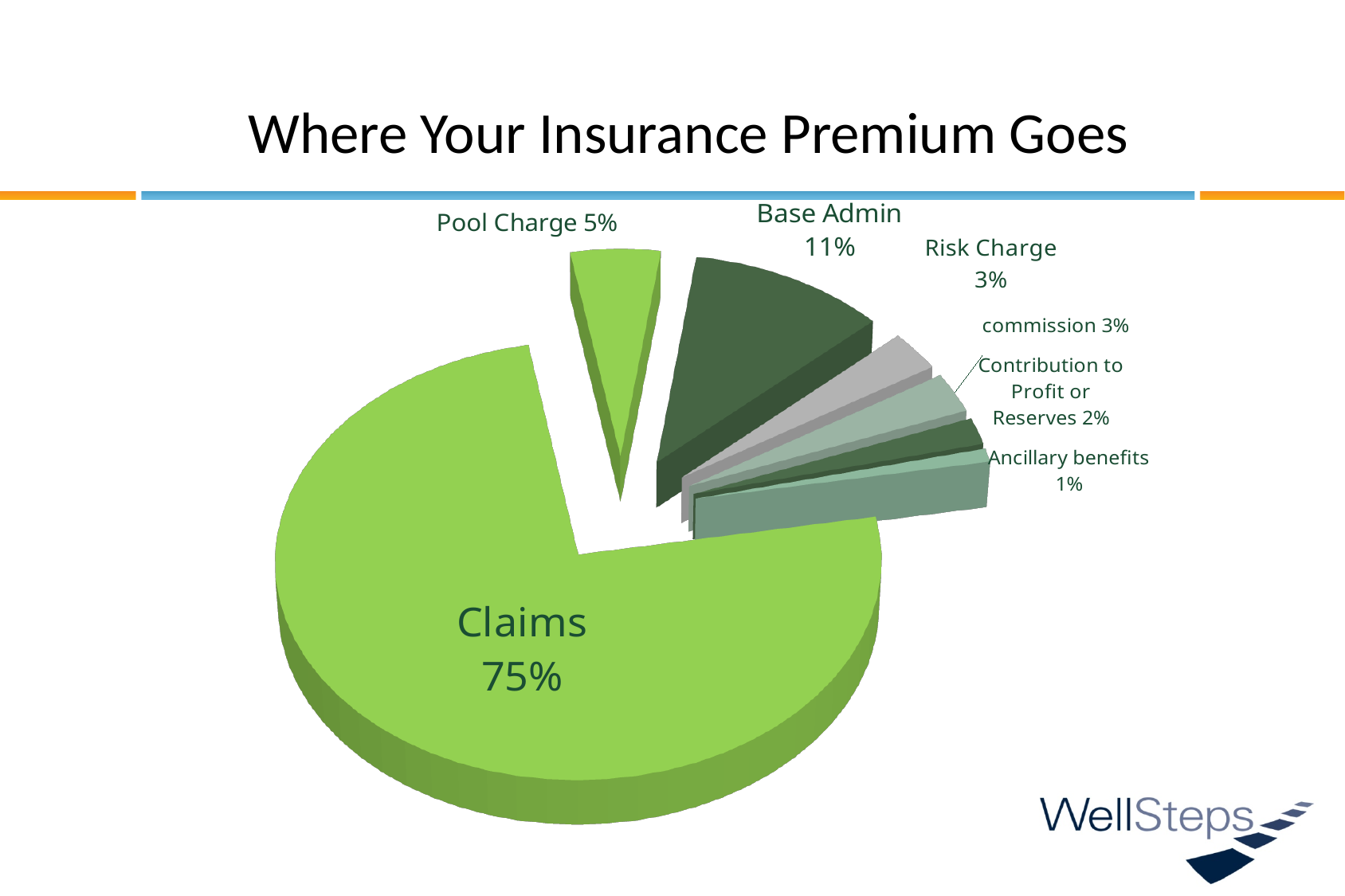
What share of the insurance premium goes to Claims? 75% Which category has the smallest slice of the pie? Ancillary benefits Which is larger, Pool Charge or Risk Charge? Pool Charge What is the value shown for Pool Charge? 5% Which category has the largest slice of the pie? Claims How many slices does the pie chart have? 7 What percentage of the premium is the Base Admin slice? 11% What is the title of the slide? Where Your Insurance Premium Goes What percentage is labelled for Ancillary benefits? 1% What share is shown for Contribution to Profit or Reserves? 2% What type of chart is shown on the slide? Pie chart What is the difference in percentage points between Claims and Base Admin? 64